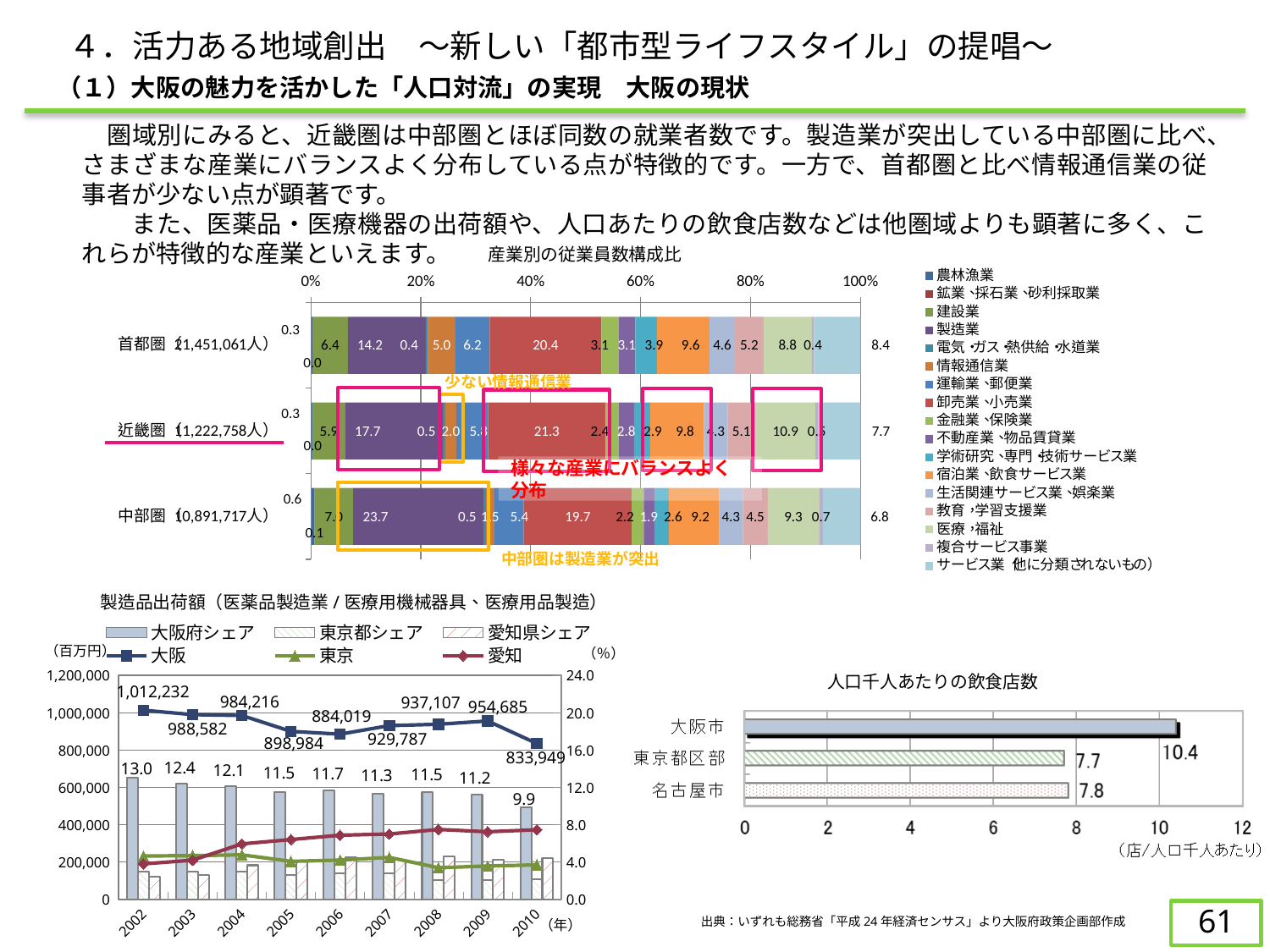
In the 人口千人あたりの飲食店数 chart, which city has the highest value? 大阪市 How many regions (bars) are shown in the 産業別の従業員数構成比 chart? 3 How many cities are shown in the 人口千人あたりの飲食店数 chart? 3 In the 産業別の従業員数構成比 chart, what is the 製造業 value for 中部圏? 23.7 How many series does the legend of the 製造品出荷額 chart list? 6 In the 製造品出荷額 chart, what is the value of the 大阪 line for 2002? 1,012,232 In the 製造品出荷額 chart, what is the 大阪府シェア value for 2010? 9.9 In the 産業別の従業員数構成比 chart, what is the 卸売業・小売業 value for 近畿圏? 21.3 In the 人口千人あたりの飲食店数 chart, what is the difference between the values for 大阪市 and 東京都区部? 2.7 What kind of chart is the 人口千人あたりの飲食店数 chart? bar chart In the 人口千人あたりの飲食店数 chart, what is the value for 大阪市? 10.4 In the 製造品出荷額 chart, does the 大阪府シェア value rise or fall from 2002 to 2010? fall